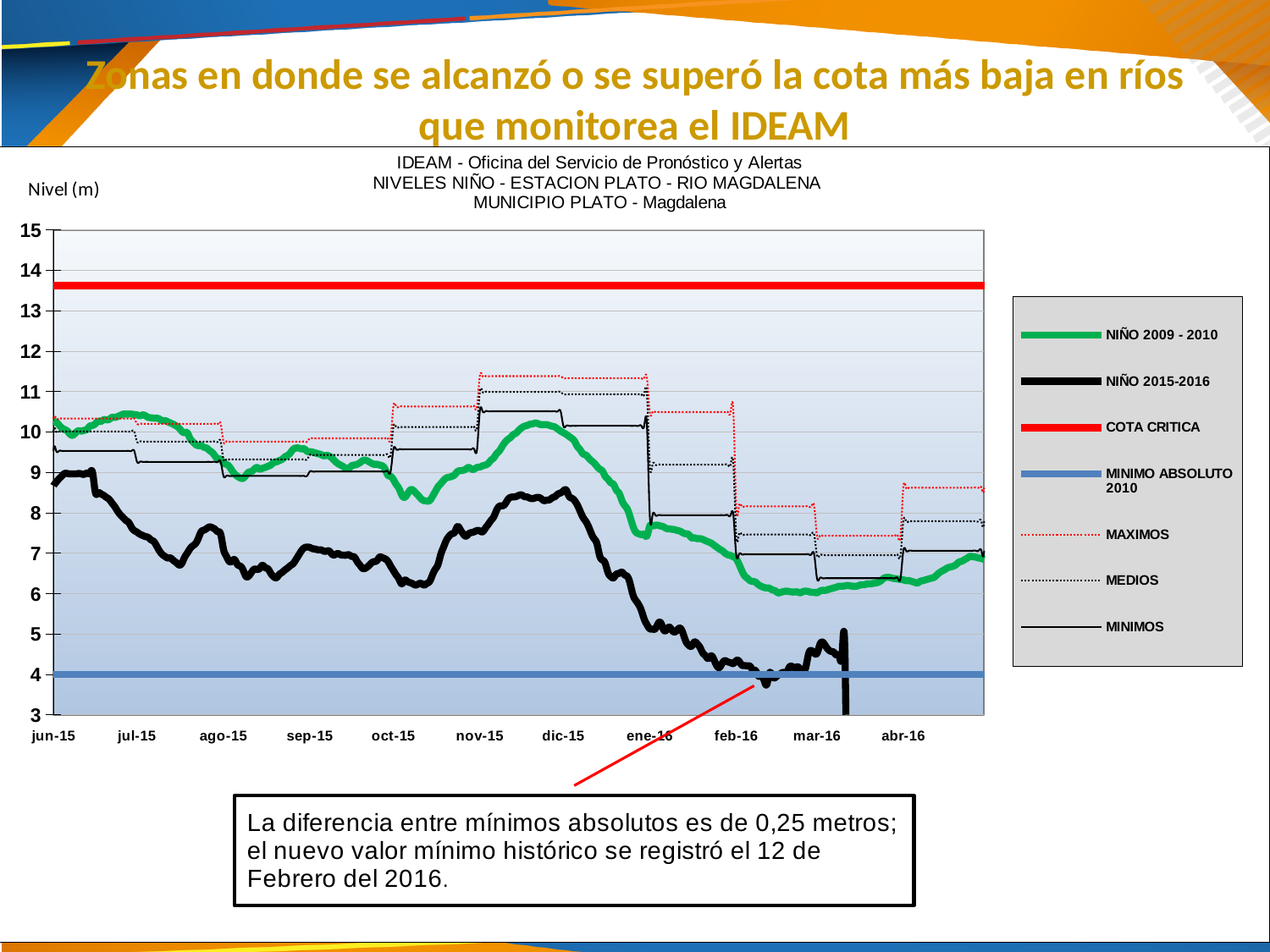
What is the label of the vertical axis of the chart? Nivel (m) Is the NIÑO 2009 - 2010 value at jun-15 greater or less than 9? greater How many series does the chart legend list? 7 Is the COTA CRITICA line greater or less than 13 on the Nivel (m) axis? greater What kind of chart is shown on the slide? line chart How many month labels are shown along the x axis of the chart? 11 Is the MINIMO ABSOLUTO 2010 line greater or less than 5 on the Nivel (m) axis? less Does the NIÑO 2009 - 2010 line rise or fall between dic-15 and feb-16? fall What colour is the COTA CRITICA line in the chart? red Does the NIÑO 2015-2016 line rise or fall between nov-15 and feb-16? fall At dic-15, which series is higher: NIÑO 2009 - 2010 or NIÑO 2015-2016? NIÑO 2009 - 2010